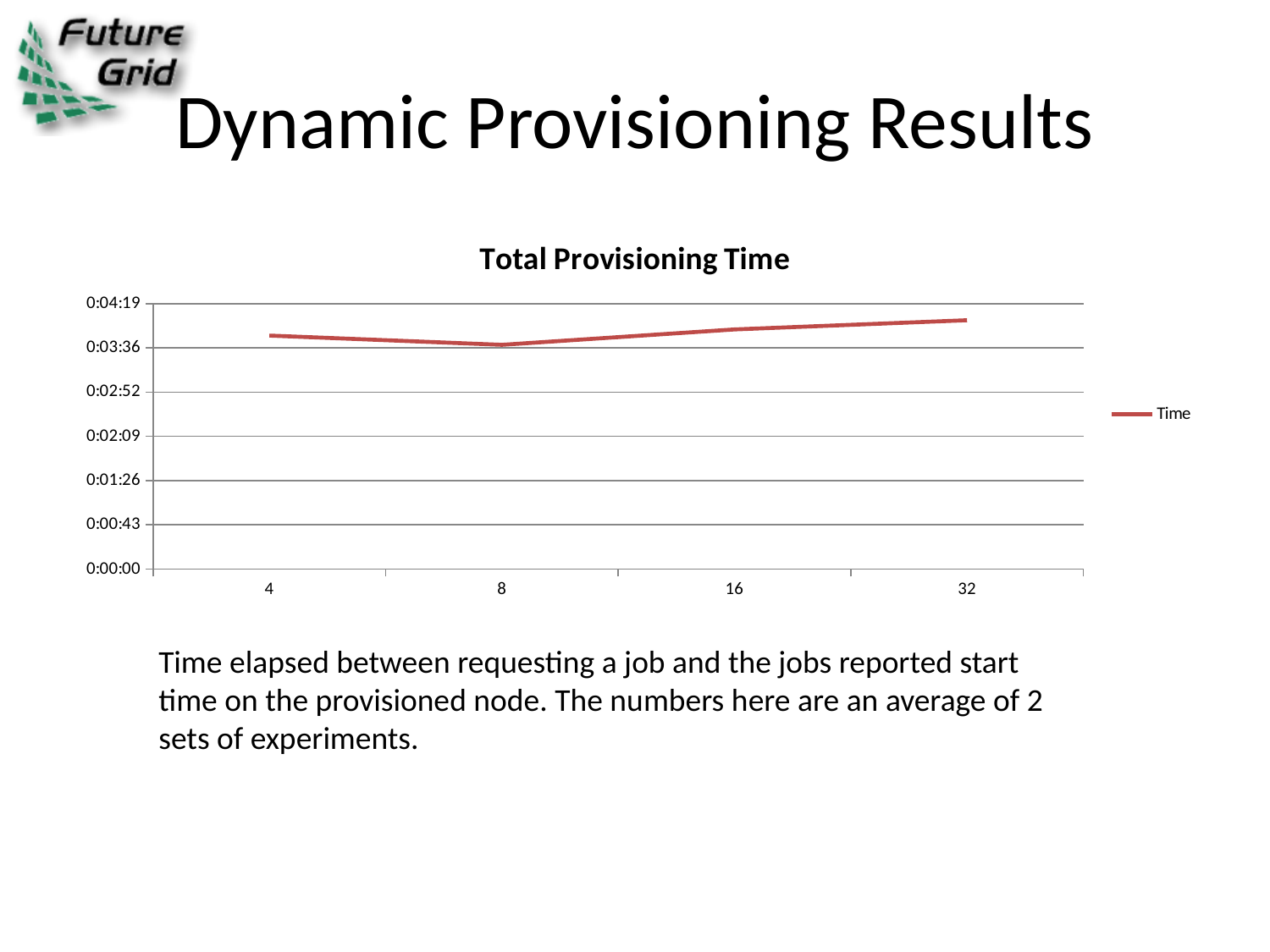
How many points are plotted along the x axis? 4 Which x-axis category has the lowest provisioning time? 8 Is the value for 32 greater or less than 0:03:36? greater How many series does the legend list? 1 Is the value for 4 greater or less than 0:02:52? greater What is the title of the chart? Total Provisioning Time Does the line rise or fall from 8 to 32 along the x axis? rise What kind of chart is shown under the title "Total Provisioning Time"? line chart What is the name of the series shown in the legend? Time Which has a larger provisioning time, 8 or 32? 32 Which x-axis category has the highest provisioning time? 32 Is the value for 8 greater or less than 0:04:19? less